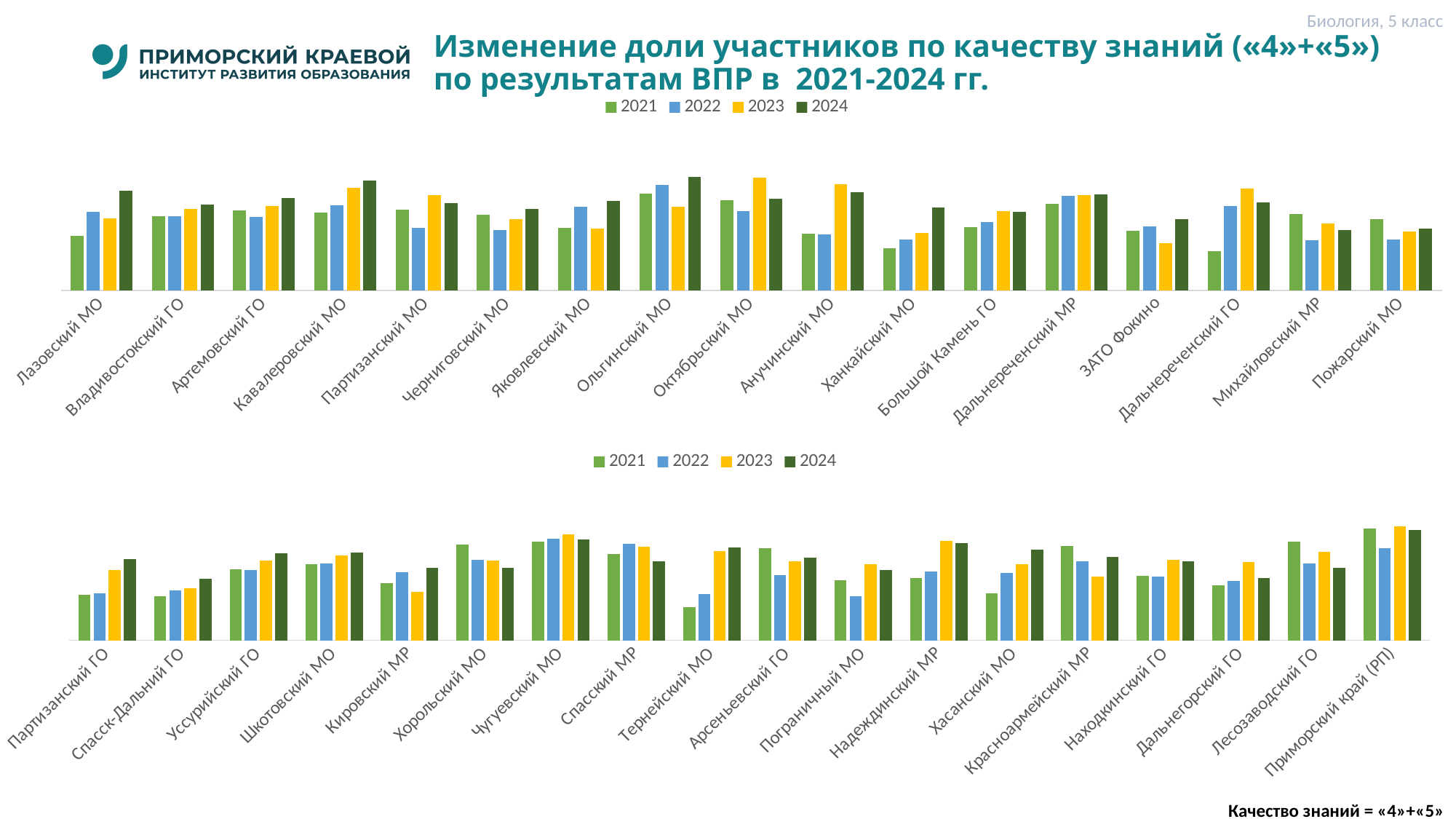
In the top chart, which year has the highest bar for Лазовский МО? 2024 Which years are listed in the legend of the bottom chart? 2021, 2022, 2023, 2024 In the top chart, for Ханкайский МО, is the 2021 bar or the 2024 bar larger? 2024 What kind of chart is the top chart on the slide? bar chart In the top chart, which year has the lowest bar for Дальнереченский ГО? 2021 In the bottom chart, which year has the lowest bar for Кировский МР? 2023 In the top chart, which year has the highest bar for Октябрьский МО? 2023 How many series does the legend of the top chart list? 4 How many categories (municipalities) are shown on the x axis of the top chart? 17 In the bottom chart, do the bars for Спасск-Дальний ГО rise or fall from 2021 to 2024? rise In the bottom chart, for Тернейский МО, is the 2021 bar or the 2024 bar larger? 2024 How many categories are shown on the x axis of the bottom chart? 18